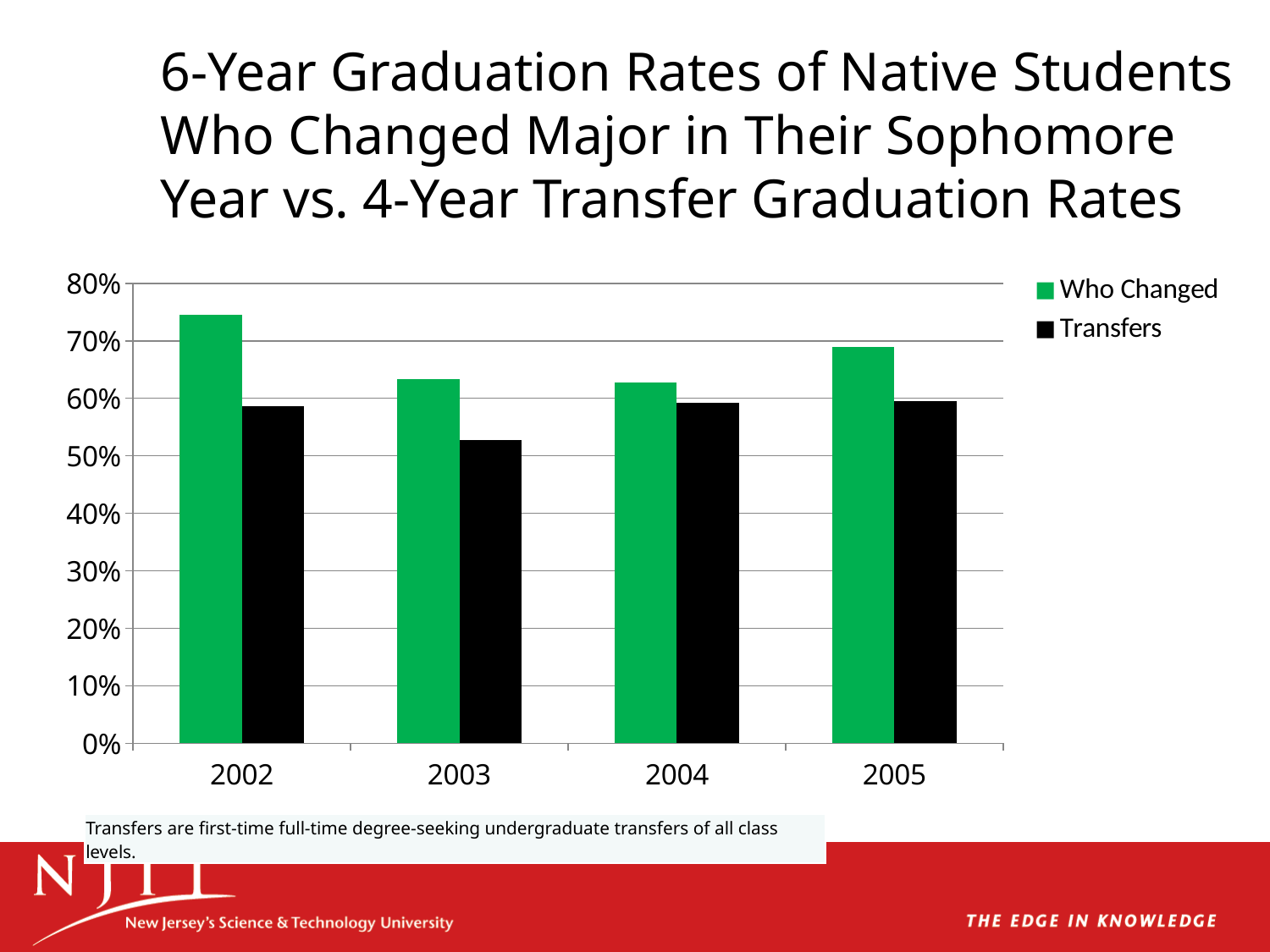
Which colour represents the Transfers series in the legend? black Is the Transfers value for 2003 greater or less than 50%? greater Is the Who Changed value for 2002 greater or less than 70%? greater In which year is the Who Changed graduation rate highest? 2002 How many series does the legend list? 2 Is the Transfers value for 2002 greater or less than 60%? less In 2002, which is larger: the Who Changed rate or the Transfers rate? Who Changed What kind of chart is shown on the slide? bar chart In which year is the Transfers graduation rate lowest? 2003 How many years are shown on the x axis? 4 In 2005, which is larger: the Who Changed rate or the Transfers rate? Who Changed